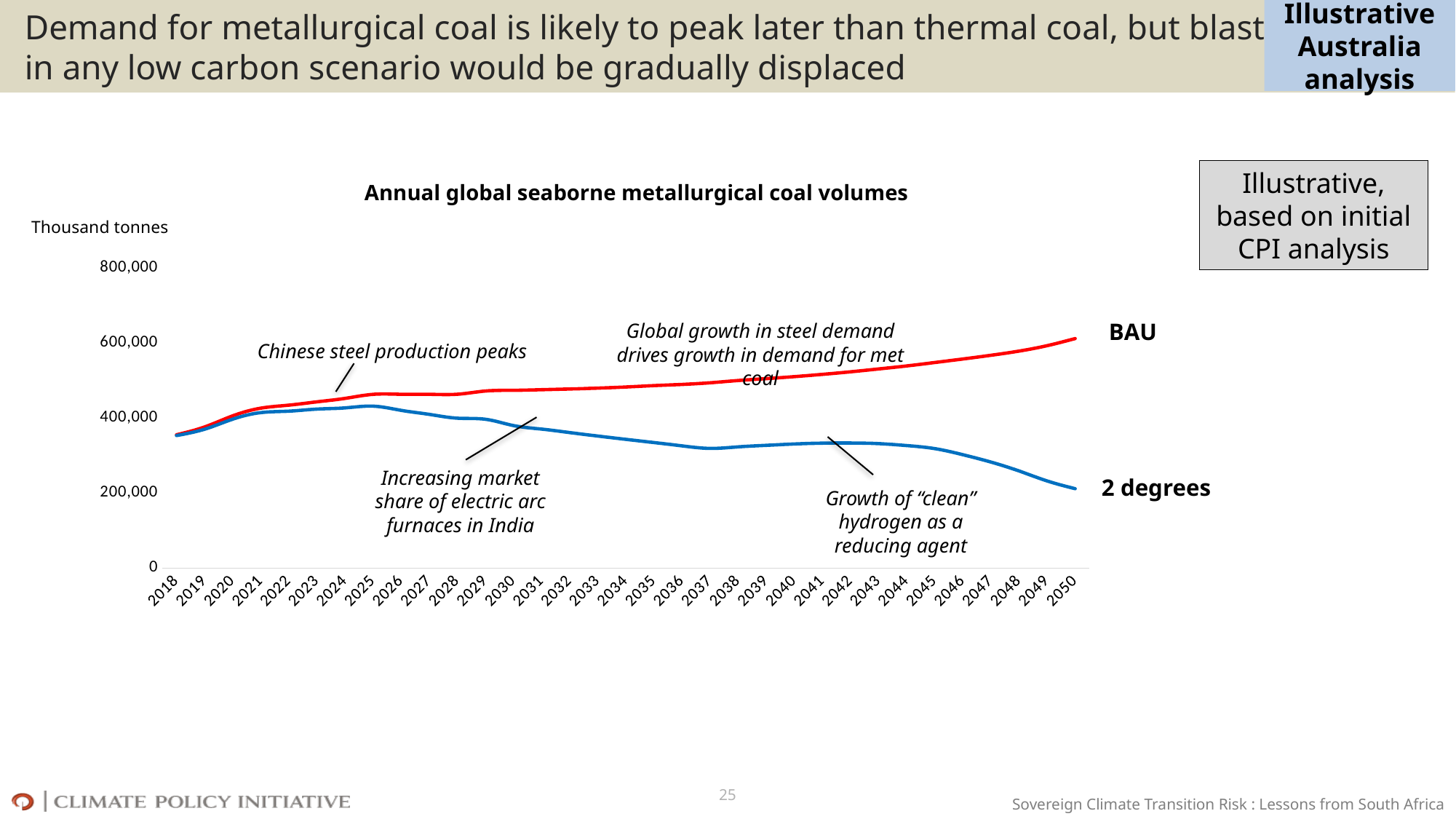
What is the title of the chart? Annual global seaborne metallurgical coal volumes Does the BAU series rise or fall from 2018 to 2050? rise In which year does the BAU series reach its highest value? 2050 How many series are plotted on the chart? 2 How many years are shown along the x axis of the chart? 33 What kind of chart is shown on the slide? line chart What unit is shown for the y axis of the chart? Thousand tonnes In which year does the 2 degrees series reach its lowest value? 2050 Is the BAU value in 2050 greater or less than 400,000? greater Is the 2 degrees value in 2050 greater or less than 400,000? less Which series is higher in 2050, BAU or 2 degrees? BAU Does the 2 degrees series rise or fall from 2025 to 2050? fall